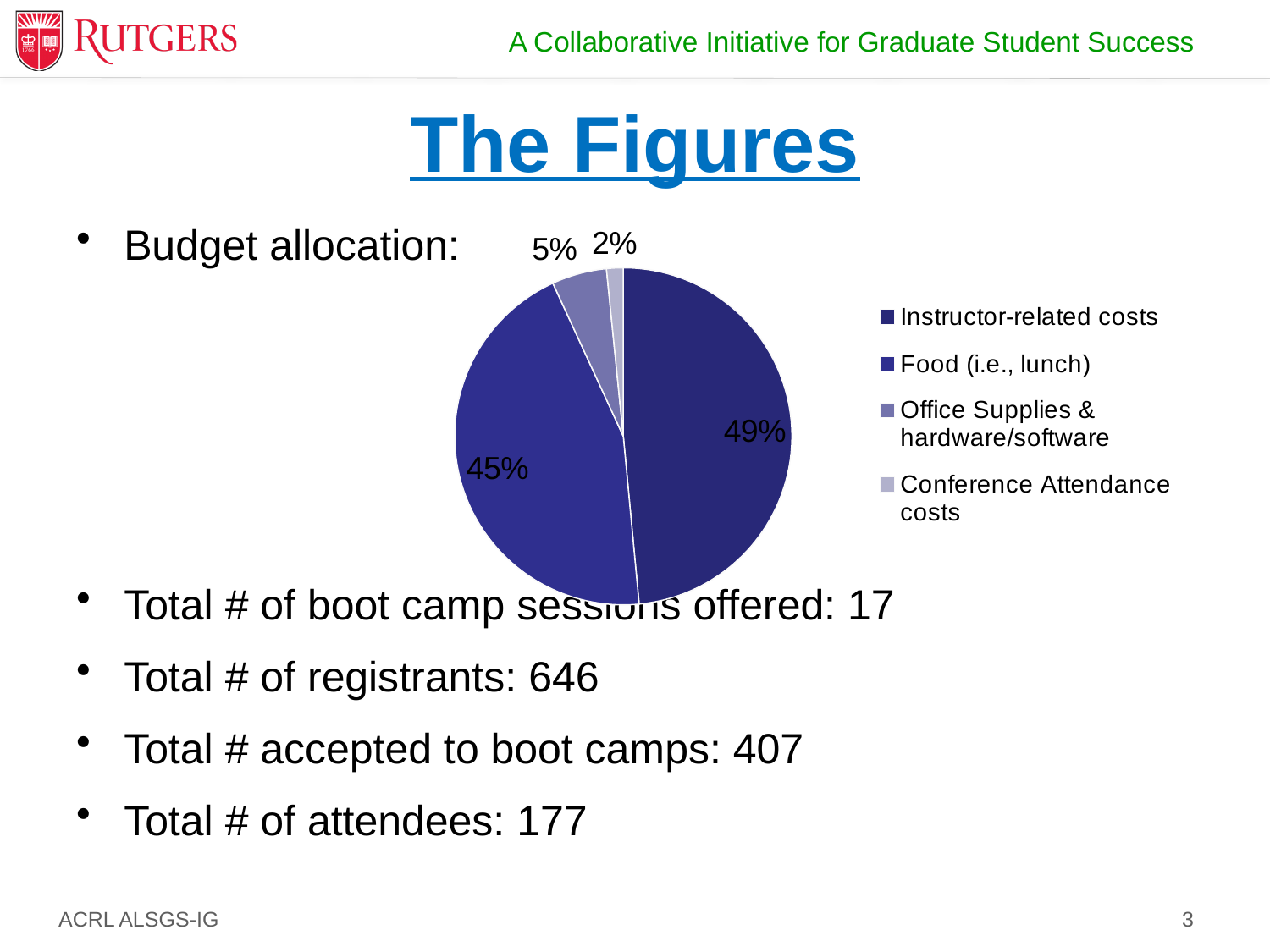
Which category has the largest share of the budget? Instructor-related costs What share of the budget goes to Conference Attendance costs? 2% Which is larger, the share for Office Supplies & hardware/software or the share for Conference Attendance costs? Office Supplies & hardware/software What is the difference in percentage points between Instructor-related costs and Food (i.e., lunch)? 4 How many slices does the pie chart have? 4 How many entries does the legend list? 4 Which category has the smallest share of the budget? Conference Attendance costs What share of the budget goes to Instructor-related costs? 49% What share of the budget goes to Office Supplies & hardware/software? 5% What does the pie chart represent, according to the bullet text next to it? Budget allocation What kind of chart is shown on the slide? pie chart